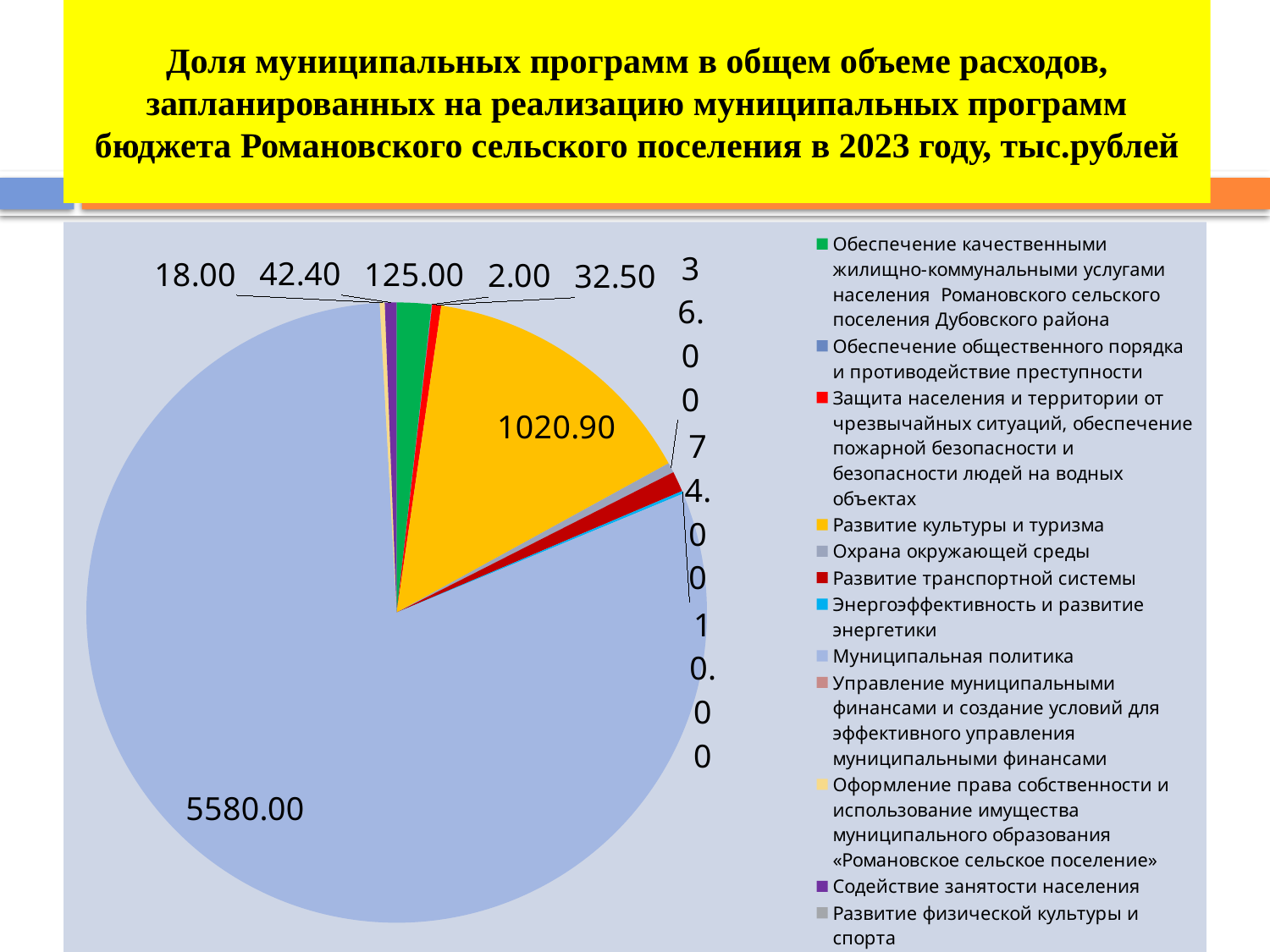
What kind of chart is shown on the slide? pie chart What is the value shown for the yellow slice (Развитие культуры и туризма)? 1020.90 What is the difference between the largest slice (5580.00) and the slice for Развитие культуры и туризма (1020.90)? 4559.10 How many categories does the legend of the pie chart list? 12 What is the value of the largest slice of the pie chart? 5580.00 In what units are the values of the chart given, according to the title? тыс.рублей Which category has the largest slice in the pie chart? Муниципальная политика What is the value shown for the green slice (Обеспечение качественными жилищно-коммунальными услугами населения)? 125.00 Which is larger: the slice for Муниципальная политика or the slice for Развитие культуры и туризма? Муниципальная политика For which year does the chart show the share of municipal programmes in the budget of Романовское сельское поселение? 2023